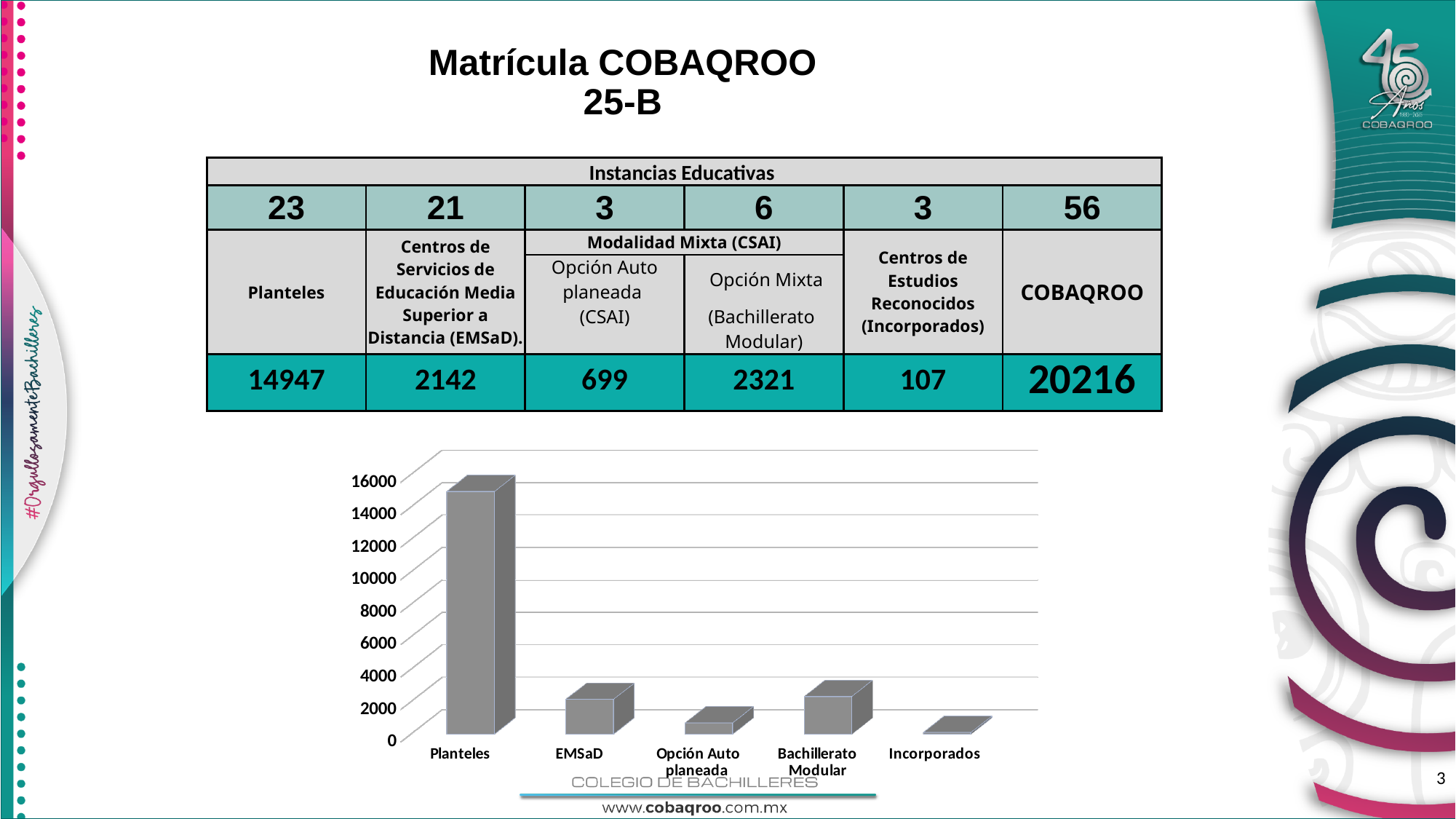
Which is larger in the chart, Planteles or EMSaD? Planteles What is the highest value shown on the chart's vertical axis? 16000 Is the value for Planteles greater or less than 14000? greater Is the value for EMSaD greater or less than 4000? less Which category has the lowest bar in the chart? Incorporados Is the value for Opción Auto planeada greater or less than 2000? less According to the table on the slide, what is the matrícula value for Planteles? 14947 Which is larger in the chart, Opción Auto planeada or Incorporados? Opción Auto planeada Which category has the highest bar in the chart? Planteles How many categories are plotted on the chart? 5 What kind of chart is shown on the slide? bar chart